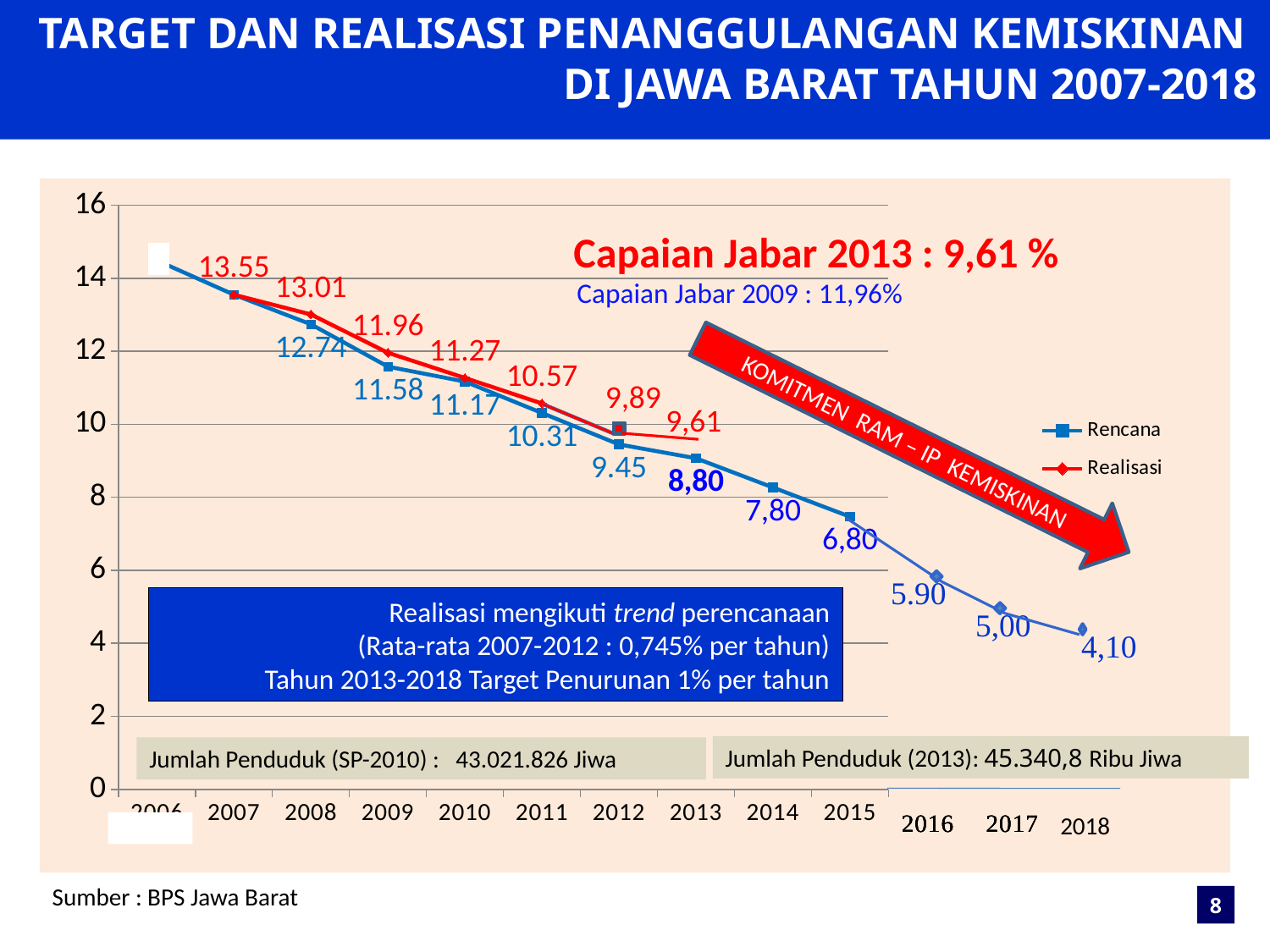
How many series does the chart legend list? 2 Do the Rencana values rise or fall from 2007 to 2018? fall What is the difference between the Realisasi and Rencana values in 2009? 0.38 What is the Rencana value for 2018? 4,10 In which year is the Rencana value lowest? 2018 What is the Realisasi value for 2009? 11.96 What is the Rencana value for 2012? 9.45 What are the two series named in the legend? Rencana and Realisasi In 2011, which series has the higher value, Rencana or Realisasi? Realisasi In which year is the Realisasi value highest? 2007 What kind of chart is shown on the slide? line chart What is the Realisasi value for 2013? 9,61